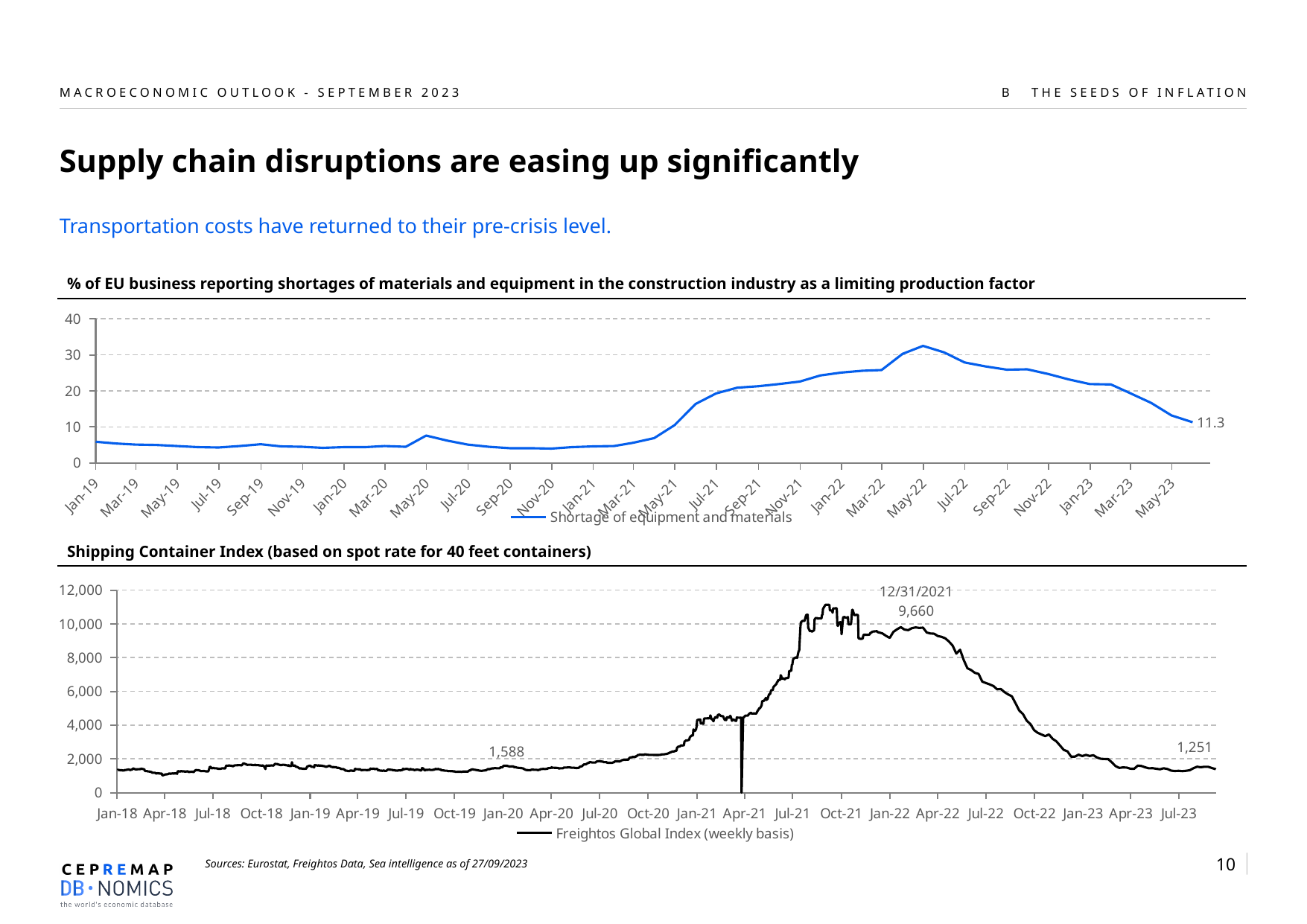
How many series does the legend of the top chart list? 1 On the Shipping Container Index chart, is the value at Jan-18 greater or less than 2,000? less What series name does the legend of the Shipping Container Index chart show? Freightos Global Index (weekly basis) On the top chart, do the values rise or fall between May-22 and May-23? fall On the Shipping Container Index chart, what is the difference between the value on 12/31/2021 and the final labeled value? 8,409 On the Shipping Container Index chart, what is the value labeled at the end of the line? 1,251 On the Shipping Container Index chart, what value is labeled for 12/31/2021? 9,660 On the top chart (% of EU business reporting shortages), what is the value shown at the end of the line? 11.3 On the top chart, is the value for Jan-19 greater or less than 10? less What kind of chart is the top chart about shortages of materials and equipment? line chart